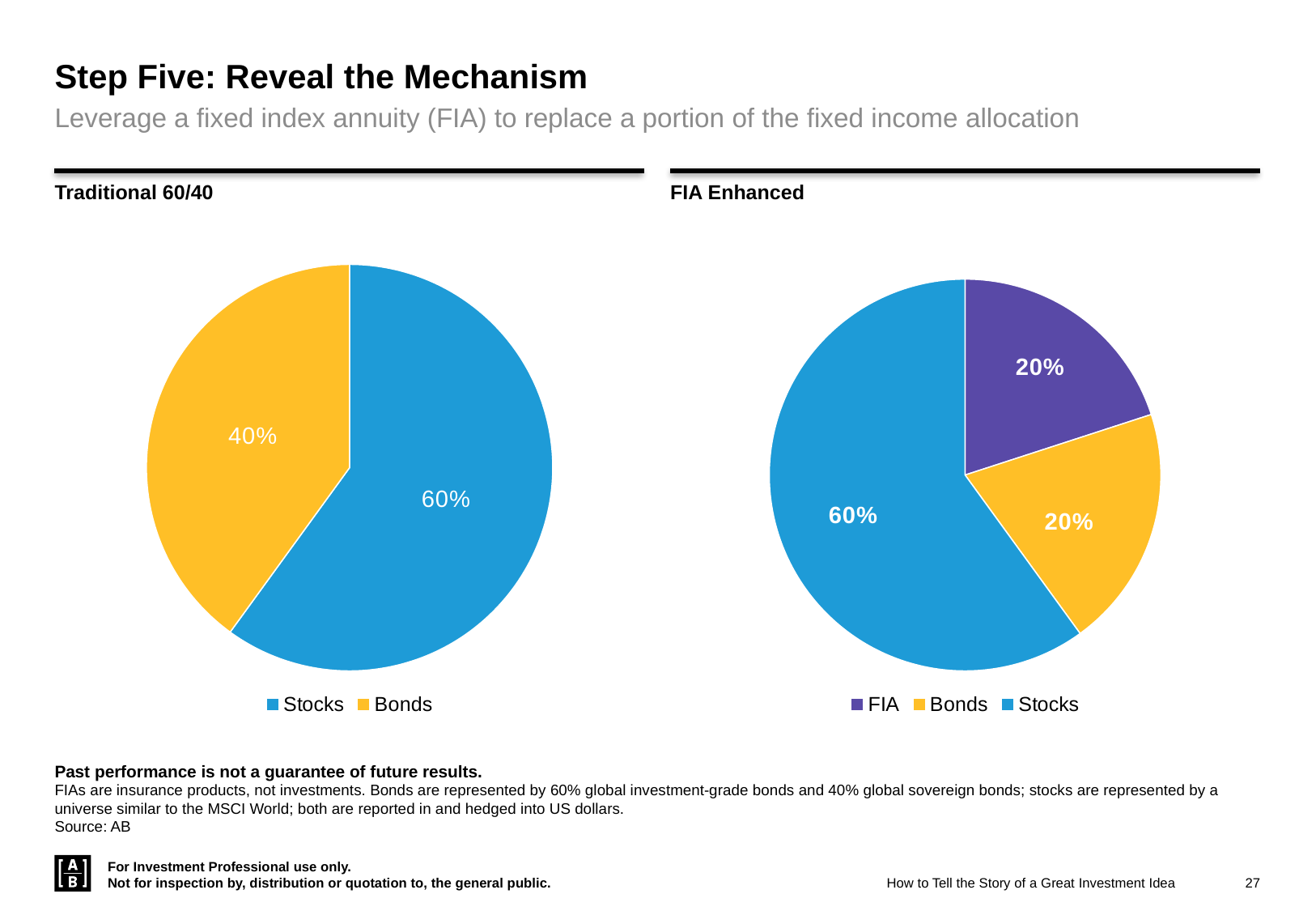
In the Traditional 60/40 chart, what is the difference between the Stocks and Bonds shares? 20% In the Traditional 60/40 chart, what share of the pie is Stocks? 60% In the FIA Enhanced chart, what share of the pie is Stocks? 60% In the FIA Enhanced chart, which category is the largest? Stocks What is the difference between the Bonds share in the Traditional 60/40 chart and the Bonds share in the FIA Enhanced chart? 20% How many slices does the FIA Enhanced chart have? 3 In the Traditional 60/40 chart, which category is the largest? Stocks In the FIA Enhanced chart, what is the value for Bonds? 20% In the FIA Enhanced chart, what share of the pie is FIA? 20% What kind of chart is the FIA Enhanced chart? Pie chart How many entries does the legend of the Traditional 60/40 chart list? 2